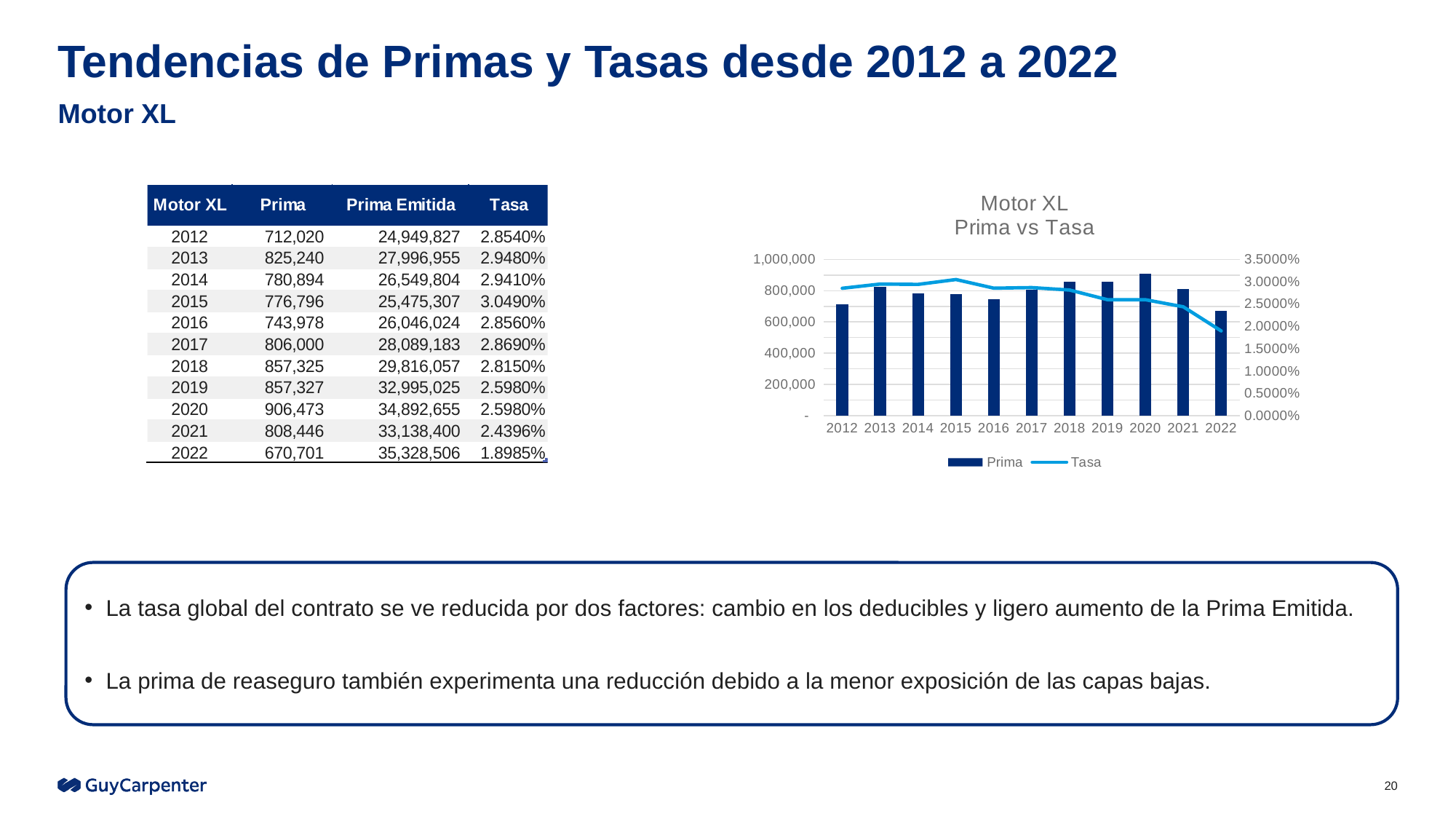
In the "Motor XL Prima vs Tasa" chart, is the Prima bar for 2013 taller or shorter than the bar for 2014? taller What kind of chart is shown under the title "Motor XL Prima vs Tasa"? A bar chart combined with a line According to the slide, what is the Prima value for 2020 plotted in the "Motor XL Prima vs Tasa" chart? 906,473 In the "Motor XL Prima vs Tasa" chart, which year has the highest Prima bar? 2020 What are the two legend entries of the "Motor XL Prima vs Tasa" chart? Prima and Tasa How many years are plotted along the x axis of the "Motor XL Prima vs Tasa" chart? 11 In the "Motor XL Prima vs Tasa" chart, in which year does the Tasa line reach its highest point? 2015 How many series does the legend of the "Motor XL Prima vs Tasa" chart list? 2 In the "Motor XL Prima vs Tasa" chart, is the Prima value for 2012 greater or less than 800,000? less In the "Motor XL Prima vs Tasa" chart, does the Tasa line rise or fall from 2015 to 2022? fall In the "Motor XL Prima vs Tasa" chart, in which year is the Tasa line at its lowest? 2022 In the "Motor XL Prima vs Tasa" chart, which year has the lowest Prima bar? 2022